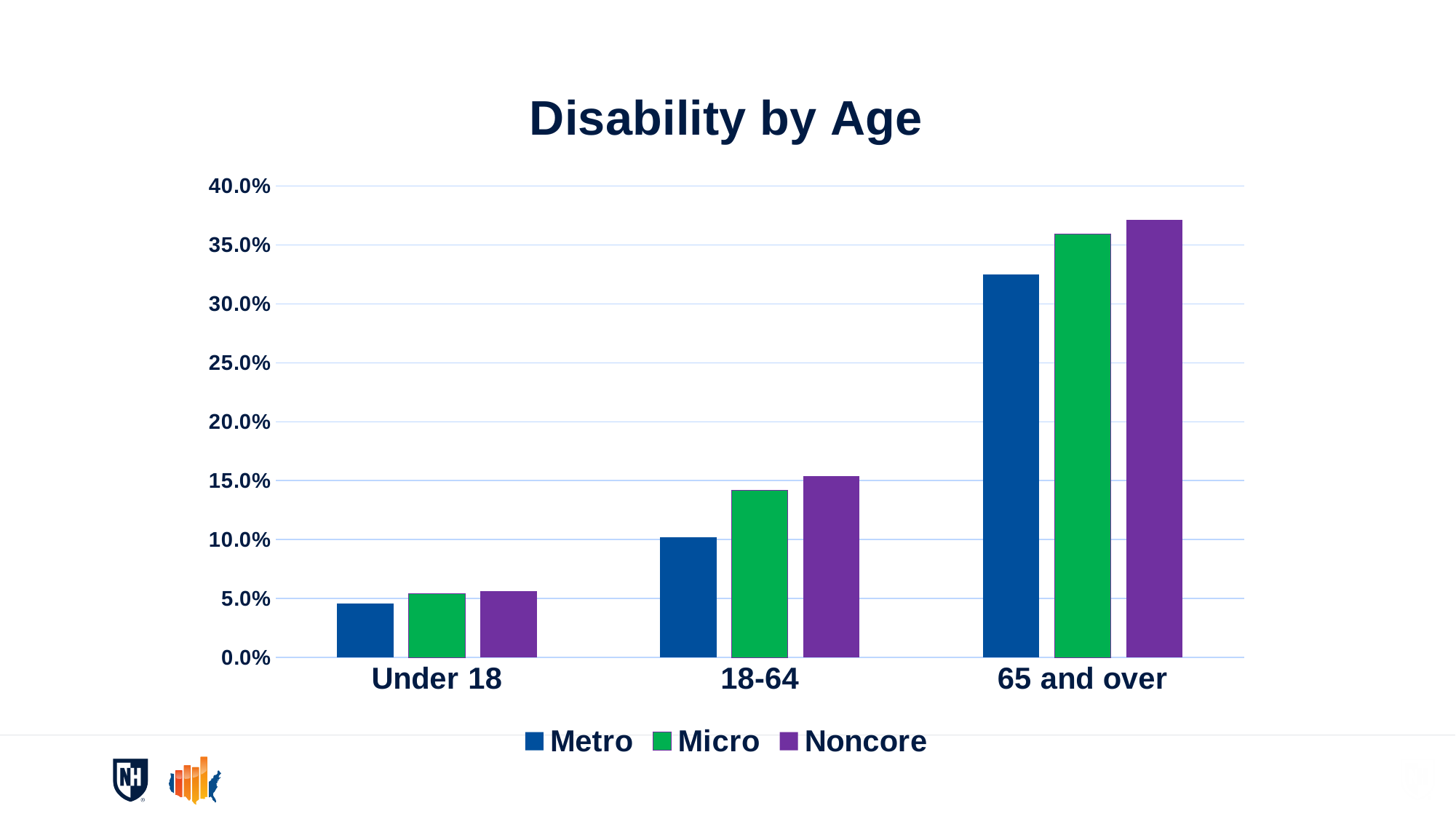
Is the value for Micro in the 18-64 category greater or less than 15.0%? less Which is larger in the 18-64 category, Metro or Noncore? Noncore Is the value for Metro in the 65 and over category greater or less than 30.0%? greater Which age category has the highest disability rate for the Metro series? 65 and over Do the Micro values rise or fall as age increases along the x axis? rise How many age categories are shown on the x axis? 3 Within the 65 and over category, which series has the highest value? Noncore Within the 18-64 category, which series has the lowest value? Metro What kind of chart is shown on the slide? bar chart What is the title of the chart? Disability by Age Which age category has the lowest disability rate for the Noncore series? Under 18 How many series does the legend list? 3